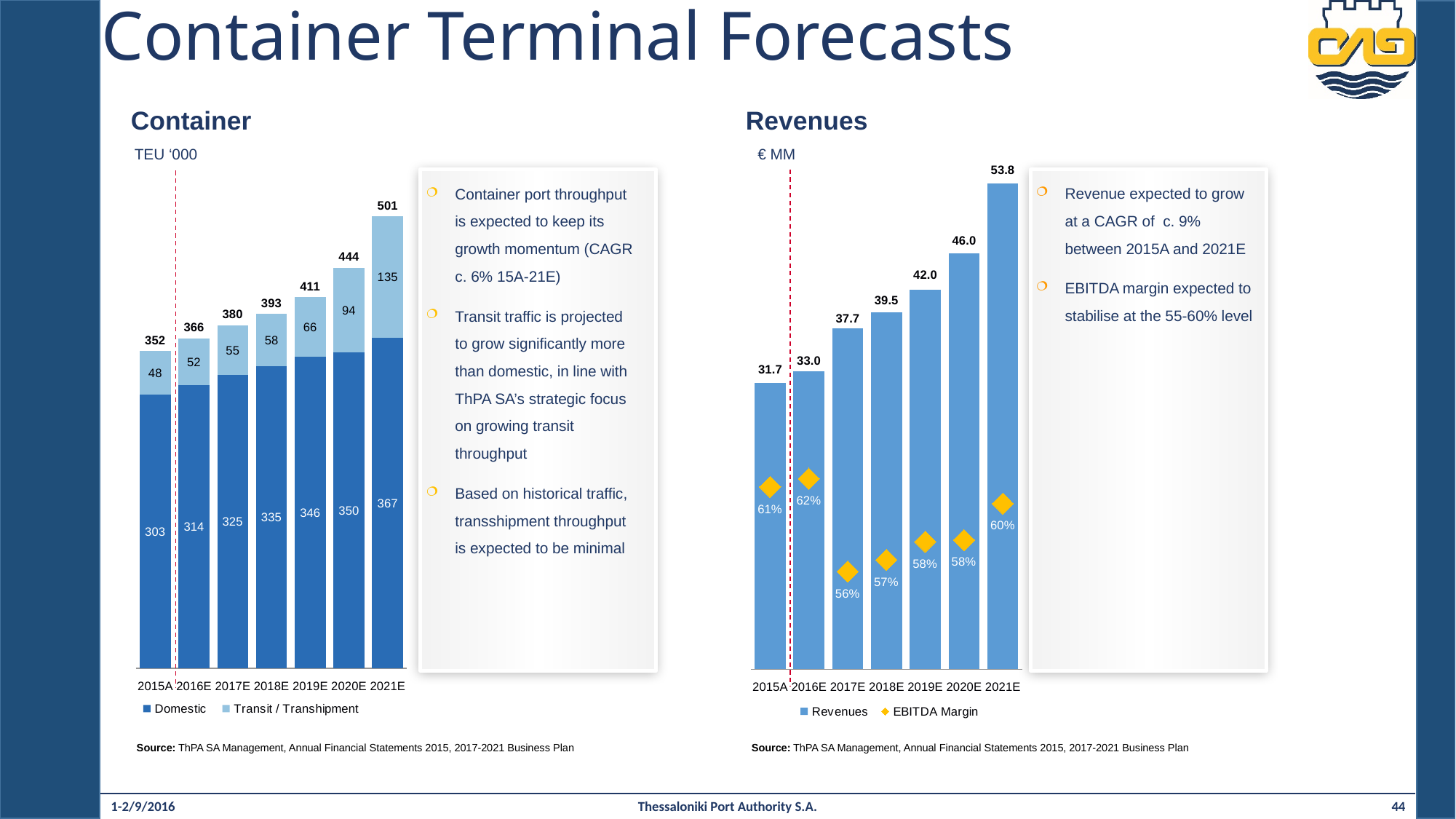
In the Revenues chart, how many years are shown on the x axis? 7 In the Container chart, how many series does the legend list? 2 In the Container chart, what is the Transit / Transshipment value for 2021E? 135 In the Container chart, which year has the highest total throughput? 2021E In the Revenues chart, what is the EBITDA Margin for 2017E? 56% In the Container chart, what is the difference between the Domestic values for 2021E and 2015A? 64 In the Revenues chart, do revenues rise or fall from 2015A to 2021E? rise In the Revenues chart, what is the revenue value for 2019E? 42.0 In the Revenues chart, which year has the lowest revenue? 2015A In the Container chart, what is the total of the stacked bar for 2018E? 393 In the Container chart, what is the Domestic value for 2015A? 303 In the Revenues chart, what is the difference between the revenue for 2021E and 2020E? 7.8